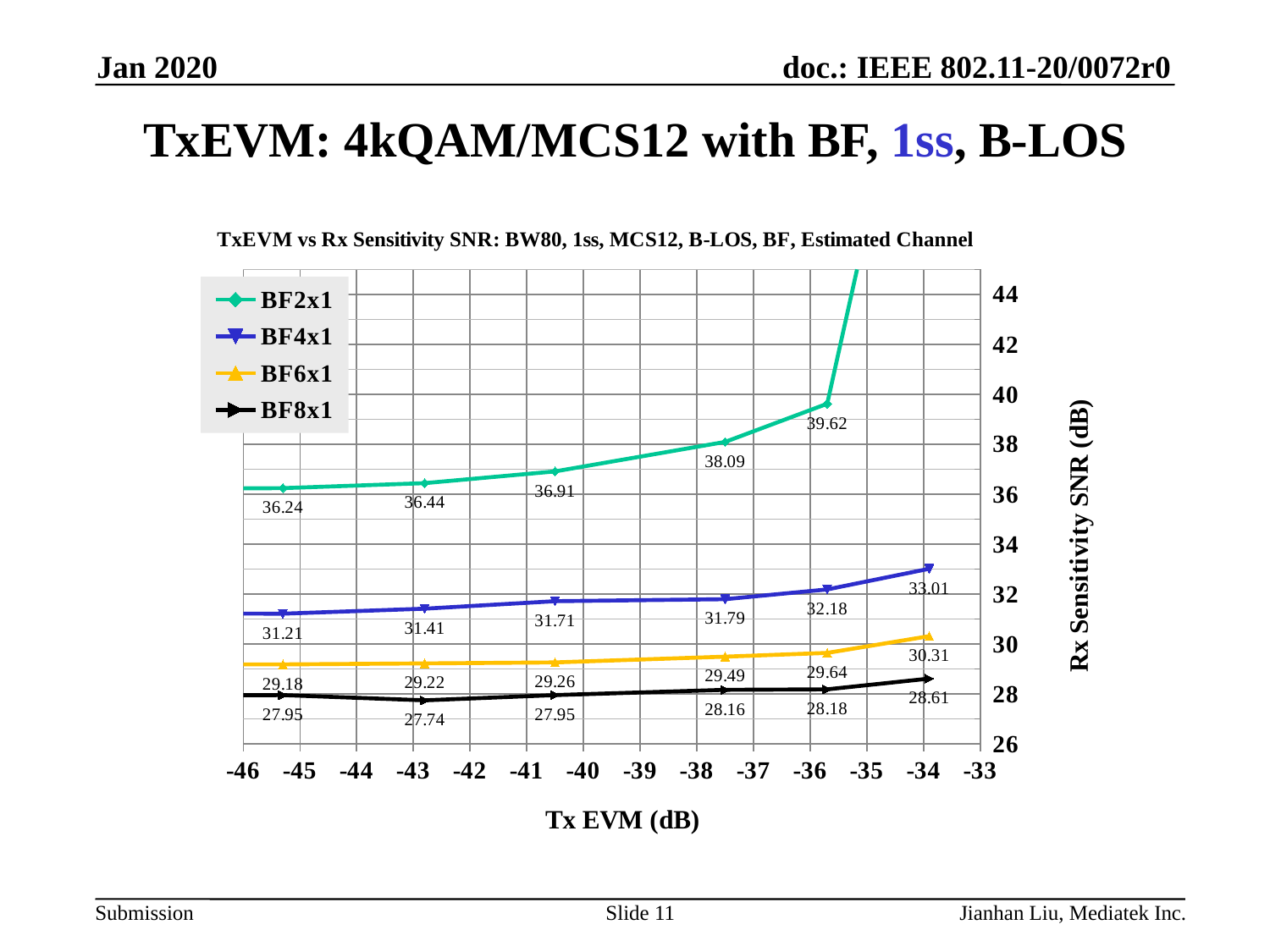
Which series has higher values, BF6x1 or BF8x1? BF6x1 How many series does the legend list? 4 What kind of chart is shown on the slide? line chart Which series has the highest Rx Sensitivity SNR values overall? BF2x1 What is the last (rightmost) labeled value of the BF4x1 series? 33.01 Do the BF4x1 values rise or fall as Tx EVM increases along the x axis? rise What is the lowest labeled value of the BF8x1 series? 27.74 What is the difference between the fifth labeled value of BF2x1 (39.62) and the fifth labeled value of BF4x1 (32.18)? 7.44 What is the chart's title? TxEVM vs Rx Sensitivity SNR: BW80, 1ss, MCS12, B-LOS, BF, Estimated Channel What is the difference between the last labeled value of BF6x1 (30.31) and its first labeled value (29.18)? 1.13 What is the first (leftmost) labeled value of the BF2x1 series? 36.24 What is the fourth labeled value of the BF2x1 series? 38.09